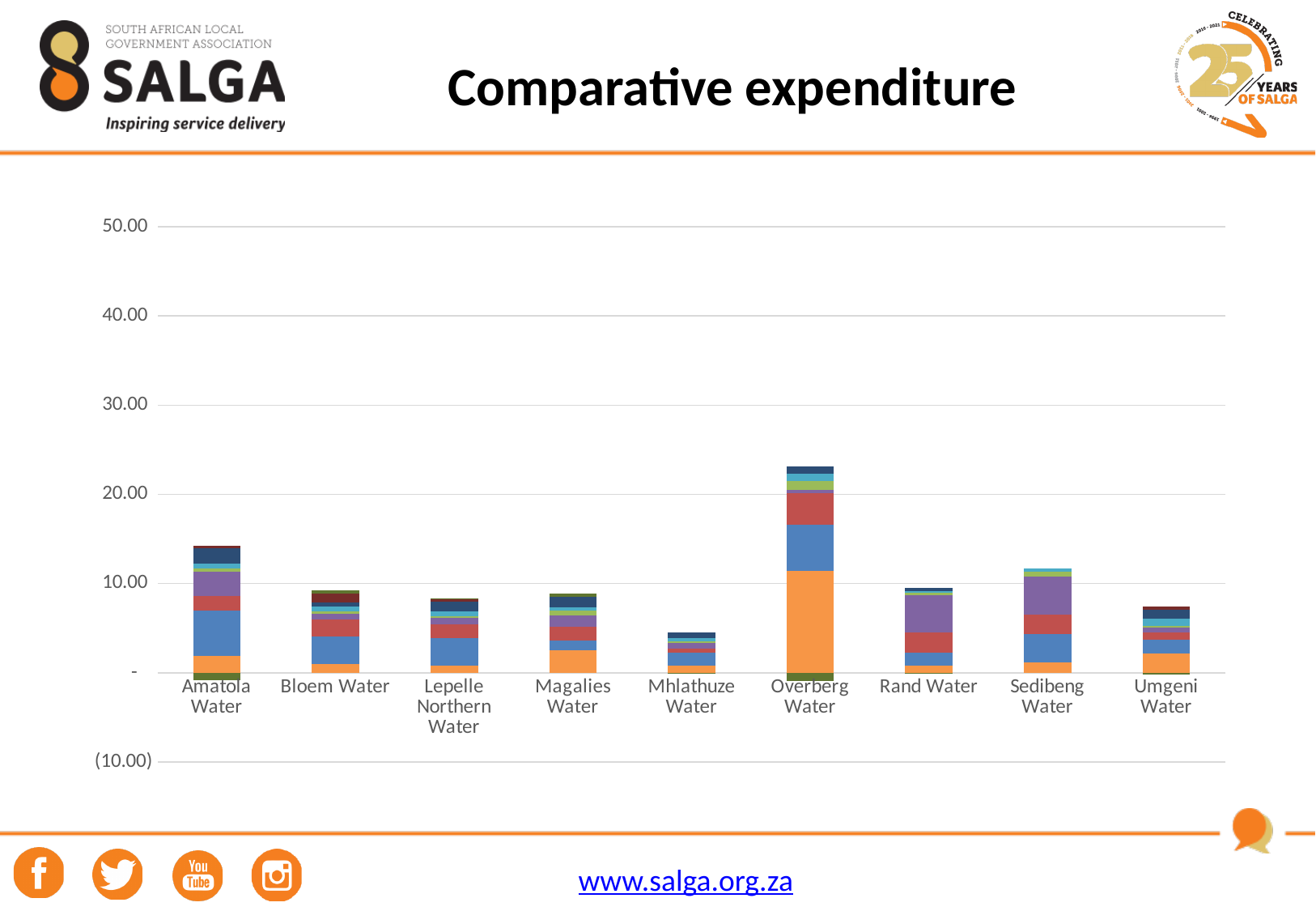
Is the total stacked value for Amatola Water greater or less than 10.00? greater How many water boards (categories) are shown on the x axis of the chart? 9 Which has the taller stacked bar, Amatola Water or Bloem Water? Amatola Water Is the total stacked value for Mhlathuze Water greater or less than 10.00? less Is the total stacked value for Umgeni Water greater or less than 10.00? less Which water board has the shortest stacked bar in the chart? Mhlathuze Water Which has the taller stacked bar, Sedibeng Water or Mhlathuze Water? Sedibeng Water What kind of chart is shown on the slide? Stacked bar chart What is the title of the slide containing the chart? Comparative expenditure Which water board has the tallest stacked bar in the chart? Overberg Water